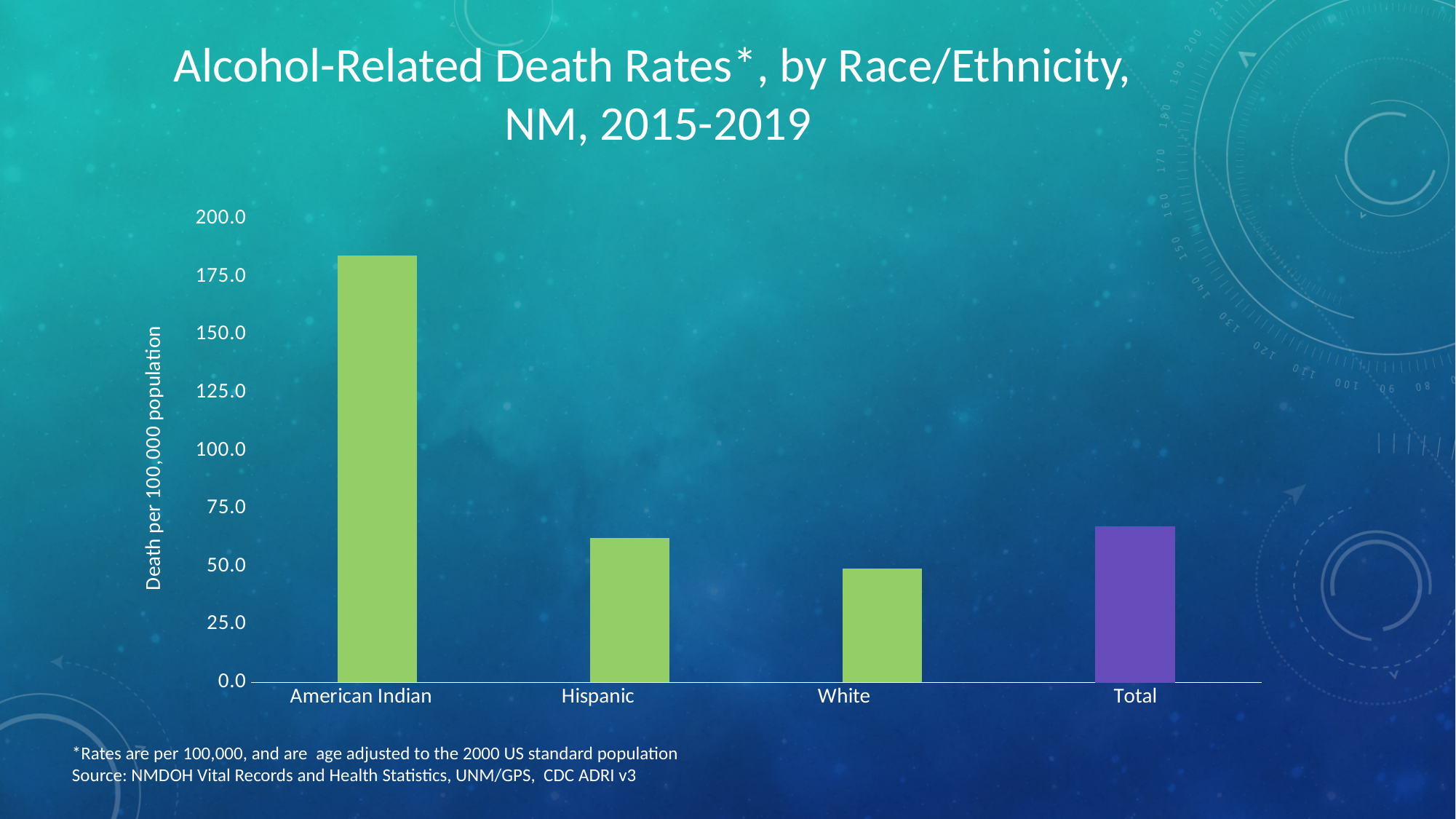
Is the value for American Indian greater or less than 150.0? greater What kind of chart is shown on the slide? bar chart Which is larger, the value for Hispanic or the value for White? Hispanic Is the value for Hispanic greater or less than 75.0? less Is the value for Total greater or less than 75.0? less Which category has the highest alcohol-related death rate? American Indian What is the label of the y axis? Death per 100,000 population Which category has the lowest alcohol-related death rate? White How many categories are shown on the x axis of the chart? 4 Which bar is shown in a different colour (purple) from the others? Total